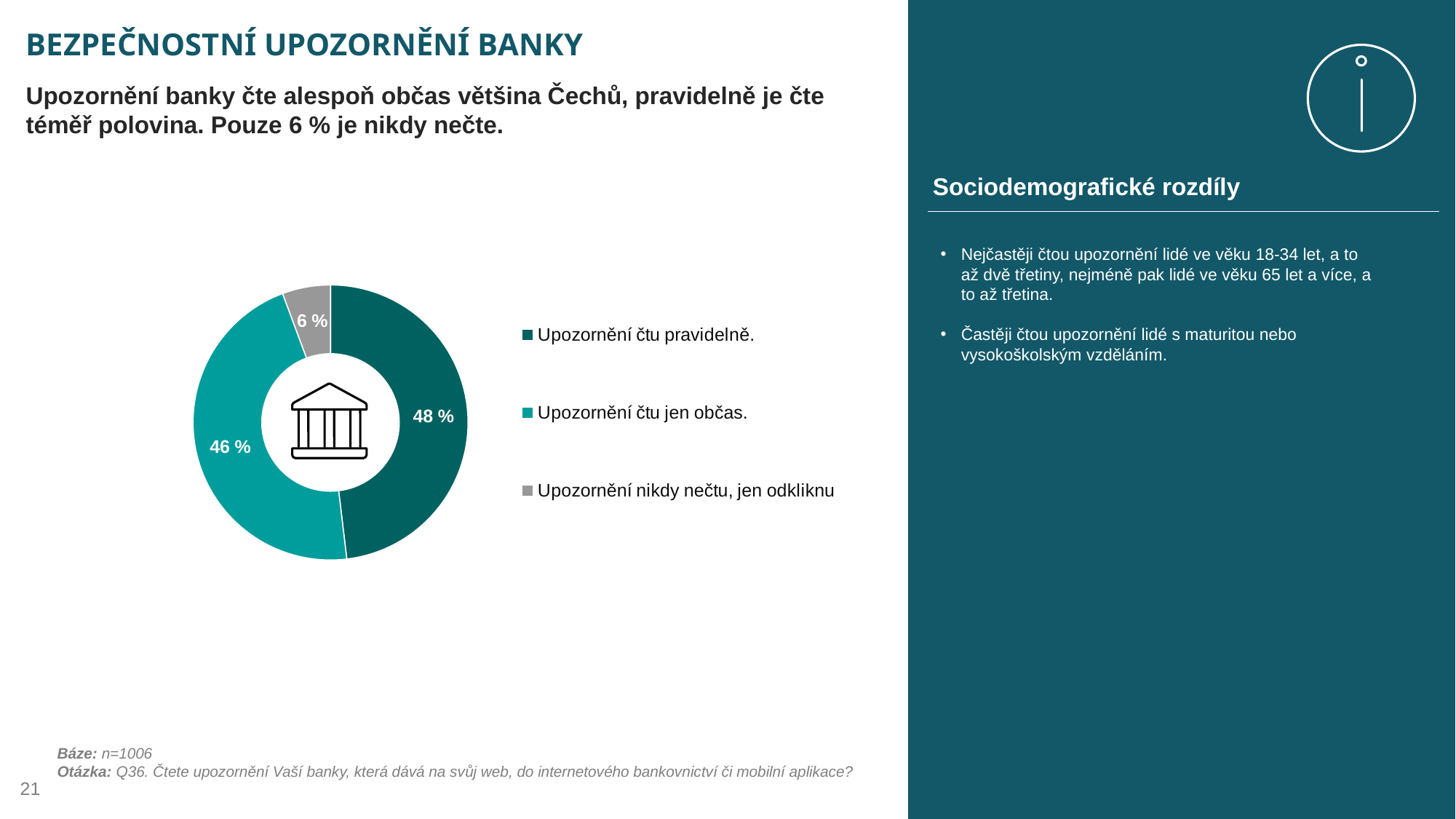
What is the sample size (Báze) stated for the chart? n=1006 What percentage of respondents say they read bank warnings regularly (Upozornění čtu pravidelně)? 48 % What percentage of respondents say they read bank warnings only occasionally (Upozornění čtu jen občas)? 46 % What percentage of respondents say they never read bank warnings and just click them away (Upozornění nikdy nečtu, jen odkliknu)? 6 % What type of chart is shown on the slide? Donut (pie) chart Which is larger: the share for 'Upozornění čtu pravidelně' or for 'Upozornění čtu jen občas'? Upozornění čtu pravidelně. What colour is the slice for 'Upozornění nikdy nečtu, jen odkliknu'? Grey How many categories does the chart show? 3 Which category has the largest share of the chart? Upozornění čtu pravidelně. What is the difference in percentage points between 'Upozornění čtu pravidelně' and 'Upozornění čtu jen občas'? 2 percentage points What is the combined share of respondents who read bank warnings at least occasionally (regularly plus occasionally)? 94 % Which category has the smallest share of the chart? Upozornění nikdy nečtu, jen odkliknu